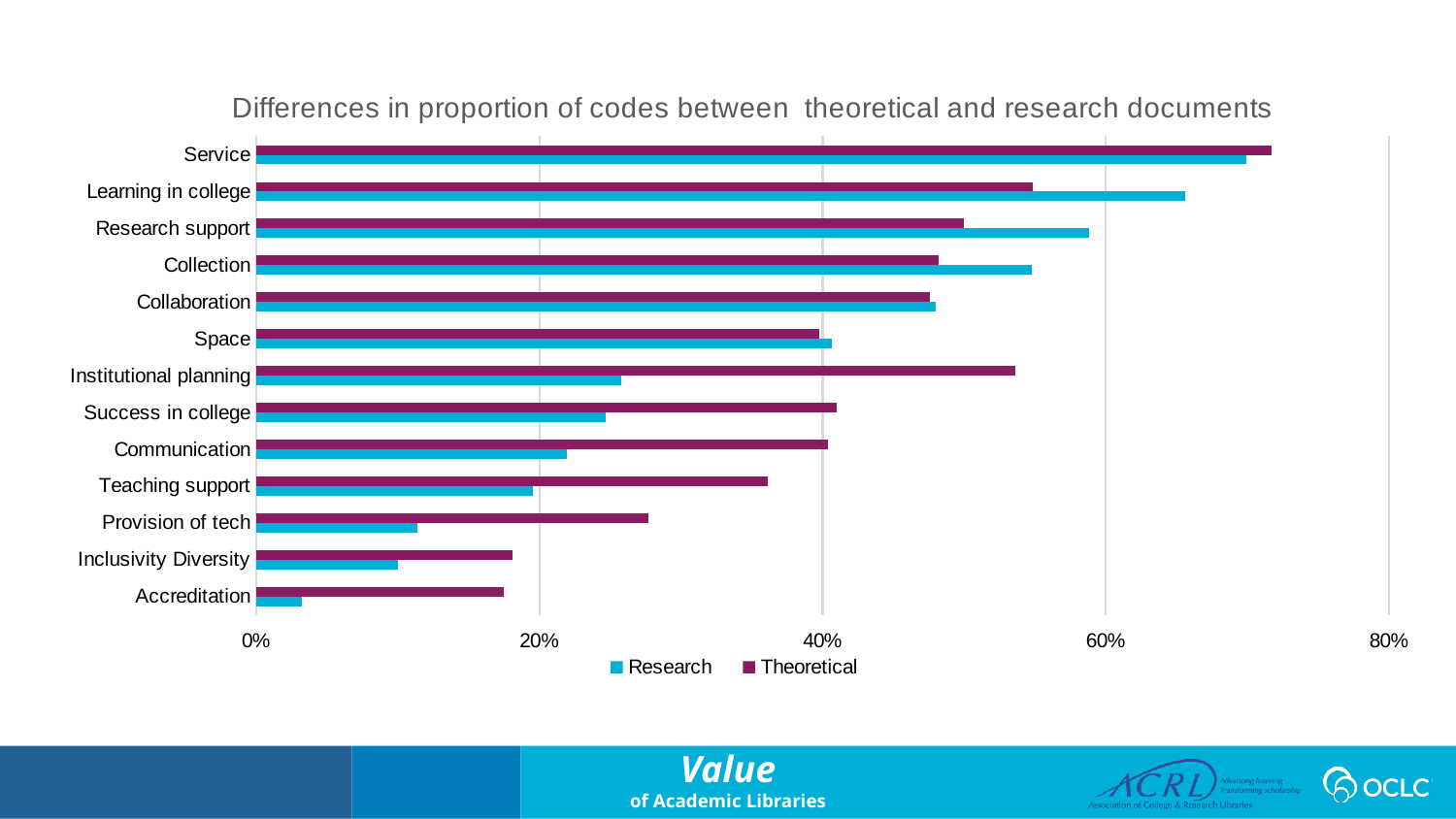
What is the title of the chart? Differences in proportion of codes between theoretical and research documents For Institutional planning, which series has the larger value, Research or Theoretical? Theoretical Which category has the lowest Theoretical value? Accreditation Is the Theoretical value for Institutional planning greater or less than 40%? greater Which category has the highest Theoretical value? Service How many series does the legend list? 2 Which category has the highest Research value? Service Which category has the lowest Research value? Accreditation Is the Research value for Learning in college greater or less than 60%? greater What kind of chart is shown on the slide? bar chart Is the Research value for Provision of tech greater or less than 20%? less How many categories are plotted on the chart? 13